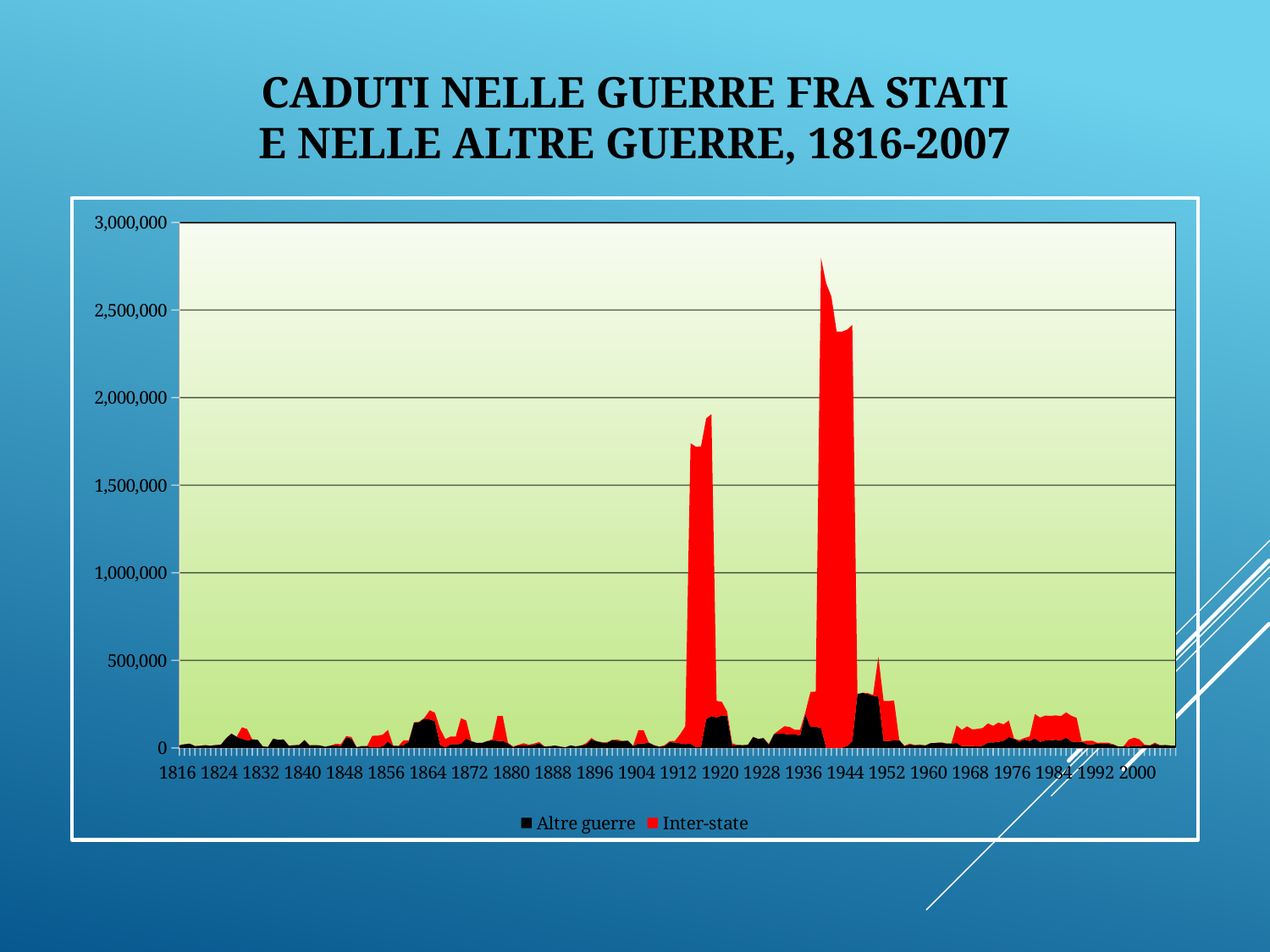
What is the highest value shown on the vertical axis? 3,000,000 Is the total value around 1900 greater or less than 500,000? less What are the two series named in the legend? Altre guerre and Inter-state How many series does the legend list? 2 Which colour represents the Inter-state series? Red Is the peak value around 1944 greater or less than 2,500,000? greater Is the peak value around 1918 greater or less than 1,500,000? greater How many year labels are shown on the horizontal axis? 24 At the peak around 1944, which series accounts for the larger share: Altre guerre or Inter-state? Inter-state What kind of chart is shown on the slide? Area chart